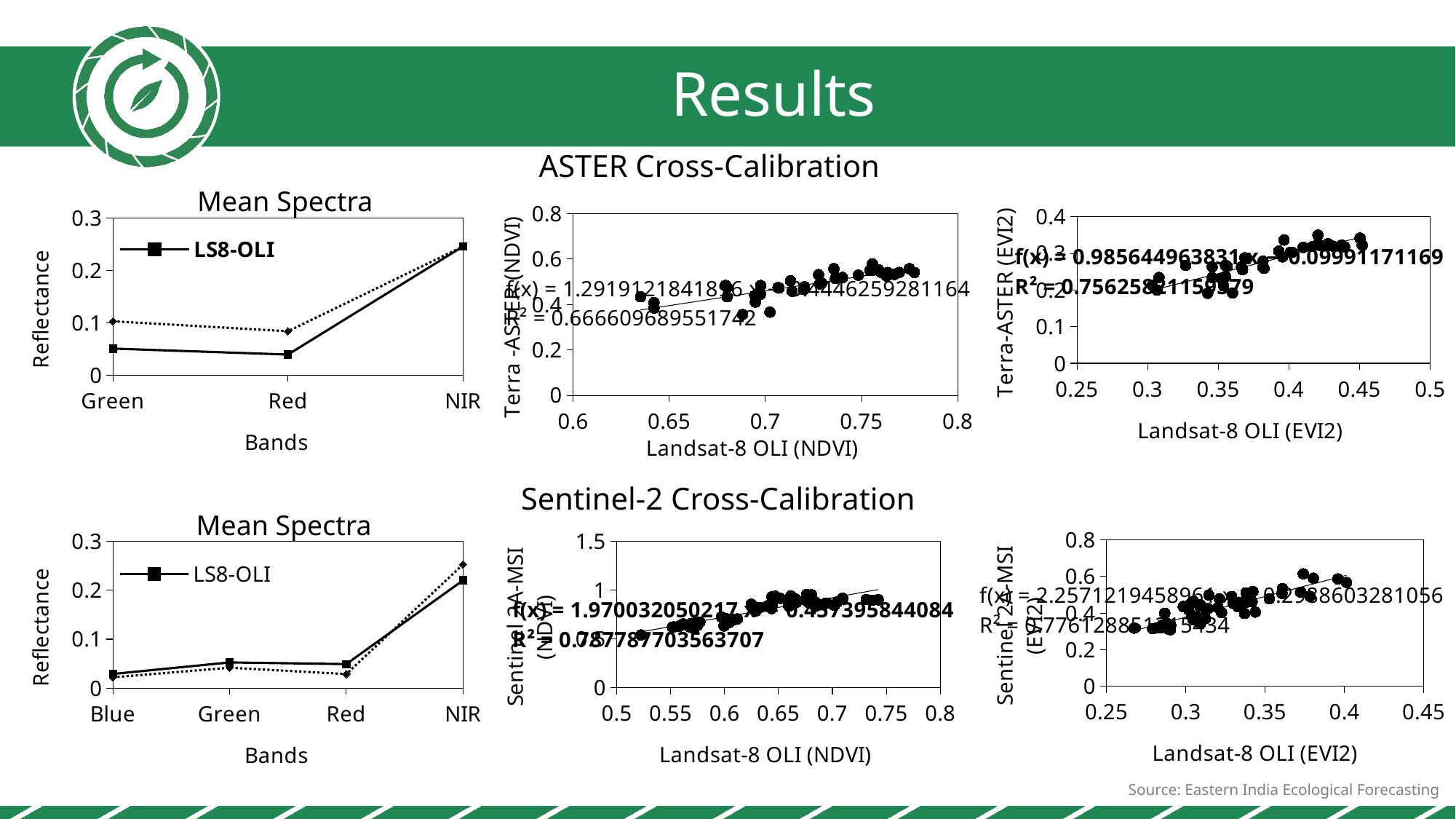
In the top-left Mean Spectra chart, how many bands are shown on the x axis? 3 In the top-left Mean Spectra chart, which band has the highest LS8-OLI reflectance? NIR In the top-middle ASTER Cross-Calibration chart, what is the x-axis title? Landsat-8 OLI (NDVI) In the bottom-left Mean Spectra chart, is the LS8-OLI reflectance for NIR greater or less than 0.2? greater In the top-left Mean Spectra chart, what kind of chart is shown? line chart In the bottom-left Mean Spectra chart, how many bands are shown on the x axis? 4 In the top-left Mean Spectra chart, how many series does the legend list? 1 In the top-left Mean Spectra chart, which band has the lowest LS8-OLI reflectance? Red In the top-left Mean Spectra chart, is the LS8-OLI reflectance for NIR greater or less than 0.2? greater In the top-left Mean Spectra chart, does the LS8-OLI reflectance rise or fall from Red to NIR? rise In the bottom-left Mean Spectra chart, is the LS8-OLI reflectance for Blue greater or less than 0.1? less In the bottom-left Mean Spectra chart, which band has the lowest LS8-OLI reflectance? Blue